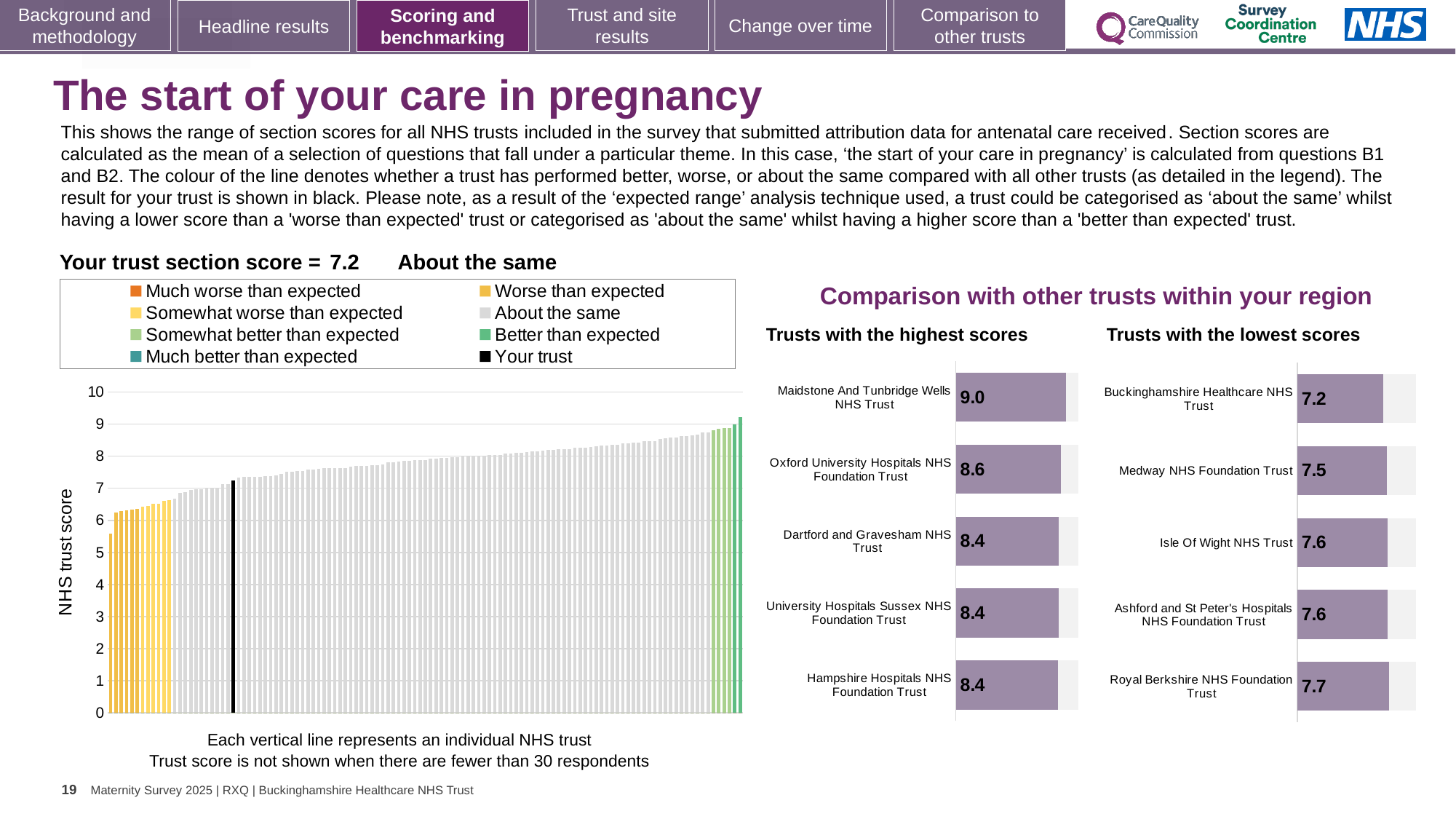
In the 'Trusts with the highest scores' chart, what is the score for Oxford University Hospitals NHS Foundation Trust? 8.6 In the large chart on the left, do the NHS trust scores rise or fall from left to right? Rise In the 'Trusts with the lowest scores' chart, what is the score for Royal Berkshire NHS Foundation Trust? 7.7 In the 'Trusts with the highest scores' chart, which trust has the highest score? Maidstone And Tunbridge Wells NHS Trust What is the section score for your trust shown on the slide? 7.2 In the 'Trusts with the highest scores' chart, what is the score for Maidstone And Tunbridge Wells NHS Trust? 9.0 In the 'Trusts with the lowest scores' chart, which has the larger score: Medway NHS Foundation Trust or Isle Of Wight NHS Trust? Isle Of Wight NHS Trust In the 'Trusts with the highest scores' chart, what is the difference between the scores of Maidstone And Tunbridge Wells NHS Trust and Oxford University Hospitals NHS Foundation Trust? 0.4 In the 'Trusts with the lowest scores' chart, what is the score for Medway NHS Foundation Trust? 7.5 In the 'Trusts with the highest scores' chart, how many trusts are shown? 5 What kind of chart is the large chart on the left showing NHS trust scores? Bar chart In the 'Trusts with the lowest scores' chart, which trust has the lowest score? Buckinghamshire Healthcare NHS Trust